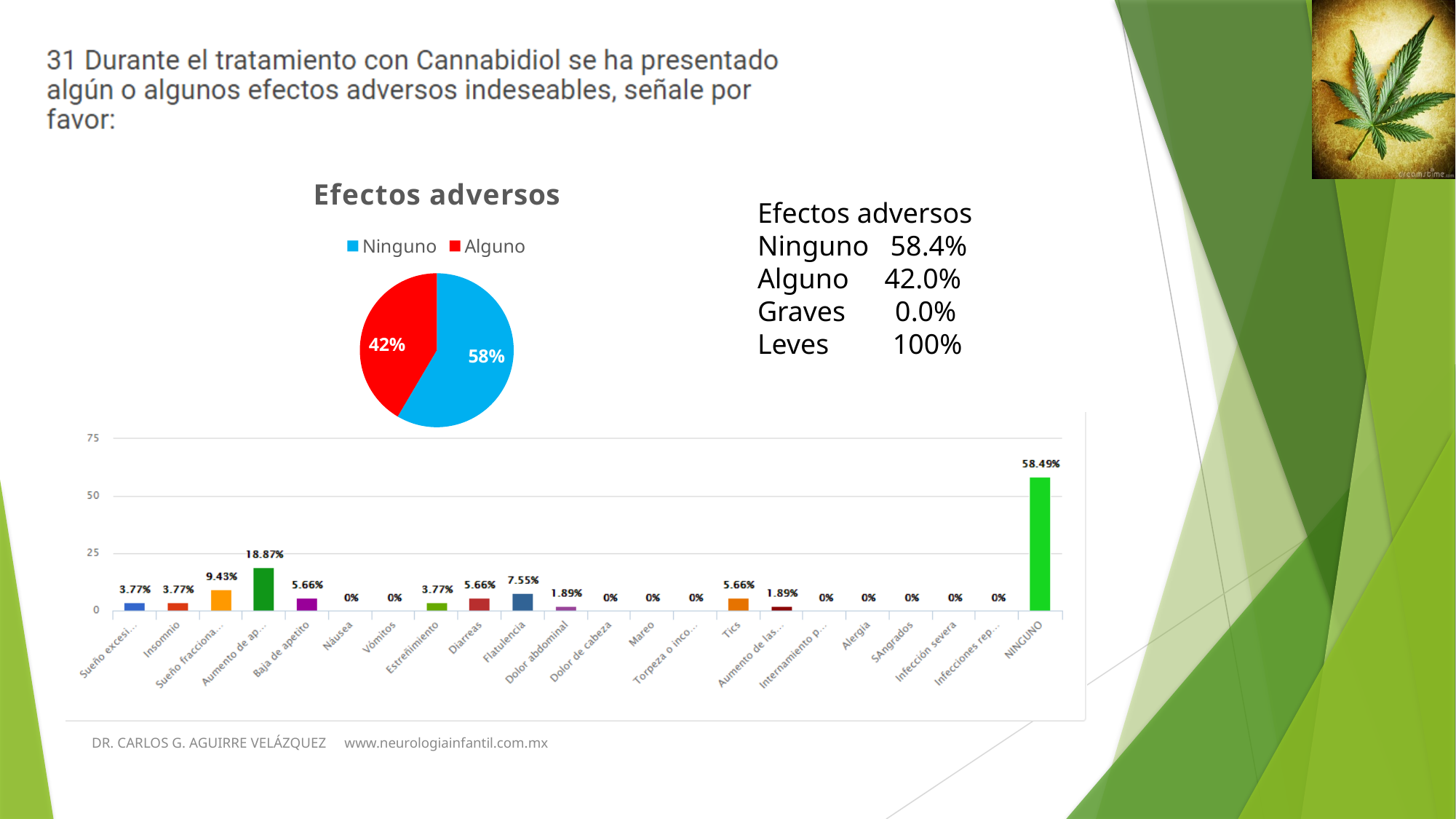
How many entries does the legend of the pie chart titled 'Efectos adversos' list? 2 In the bar chart at the bottom of the slide, what is the value for Insomnio? 3.77% In the bar chart at the bottom of the slide, which category has the highest value? NINGUNO In the pie chart titled 'Efectos adversos', what share is labelled for Alguno? 42% In the pie chart titled 'Efectos adversos', what share is labelled for Ninguno? 58% In the bar chart at the bottom of the slide, what is the value for Flatulencia? 7.55% In the pie chart titled 'Efectos adversos', which slice is larger, Ninguno or Alguno? Ninguno In the bar chart at the bottom of the slide, is the value for NINGUNO greater or less than 50? greater In the bar chart at the bottom of the slide, what is the difference between the values for Diarreas and Dolor abdominal? 3.77% In the pie chart titled 'Efectos adversos', what colour is the Alguno slice? Red In the bar chart at the bottom of the slide, what is the value for NINGUNO? 58.49% What kind of chart is the chart at the bottom of the slide? Bar chart